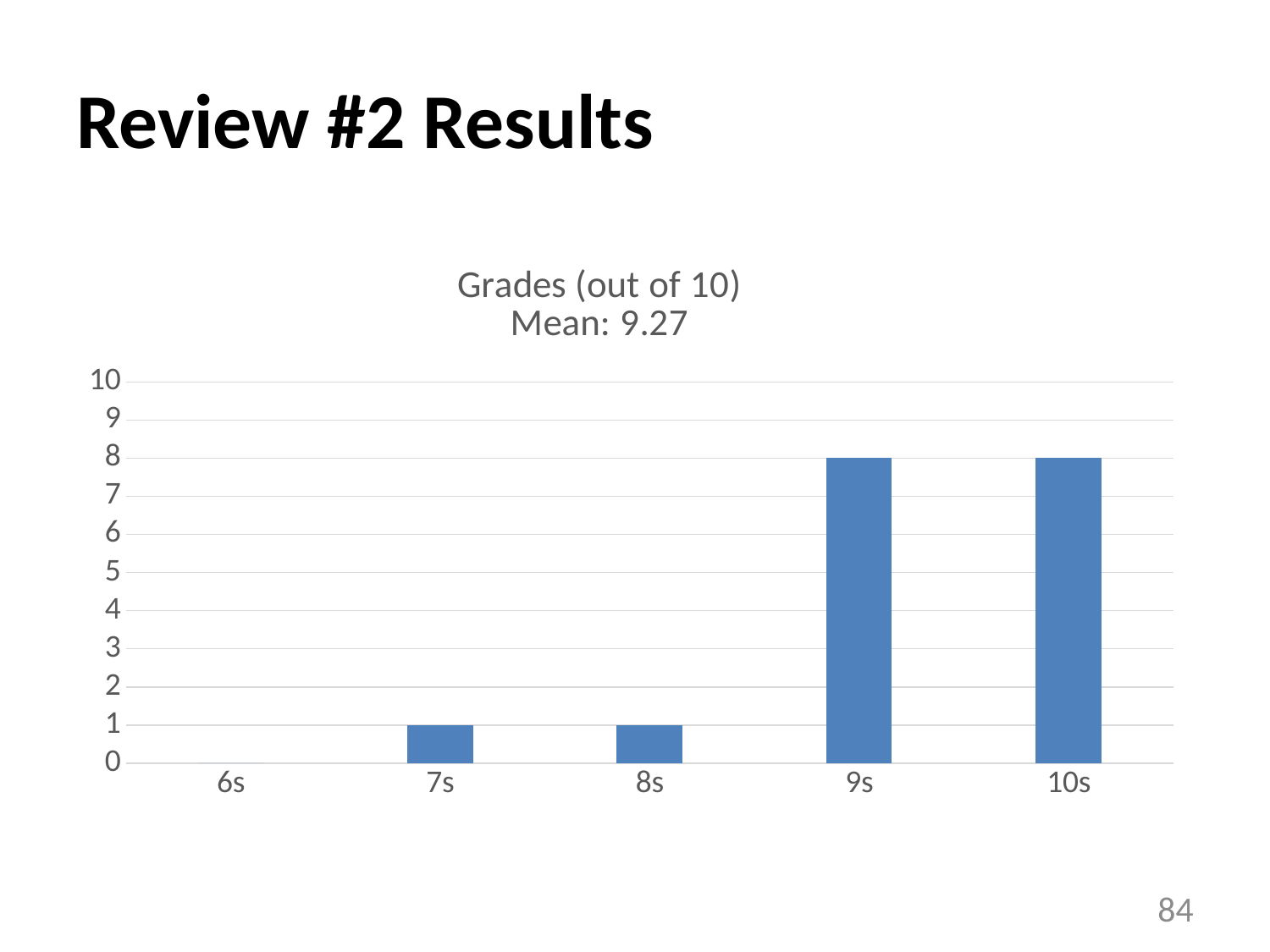
What mean value is stated in the chart title? 9.27 What kind of chart is shown on the slide? bar chart What is the value for 7s? 1 What is the value for 9s? 8 Which is larger, the value for 10s or the value for 8s? 10s How many categories are shown on the x axis? 5 Is the value for 9s greater or less than 5? greater What is the title of the chart? Grades (out of 10) Mean: 9.27 What is the value for 8s? 1 What is the difference between the values for 9s and 7s? 7 What is the value for 10s? 8 Is the value for 7s greater or less than 5? less